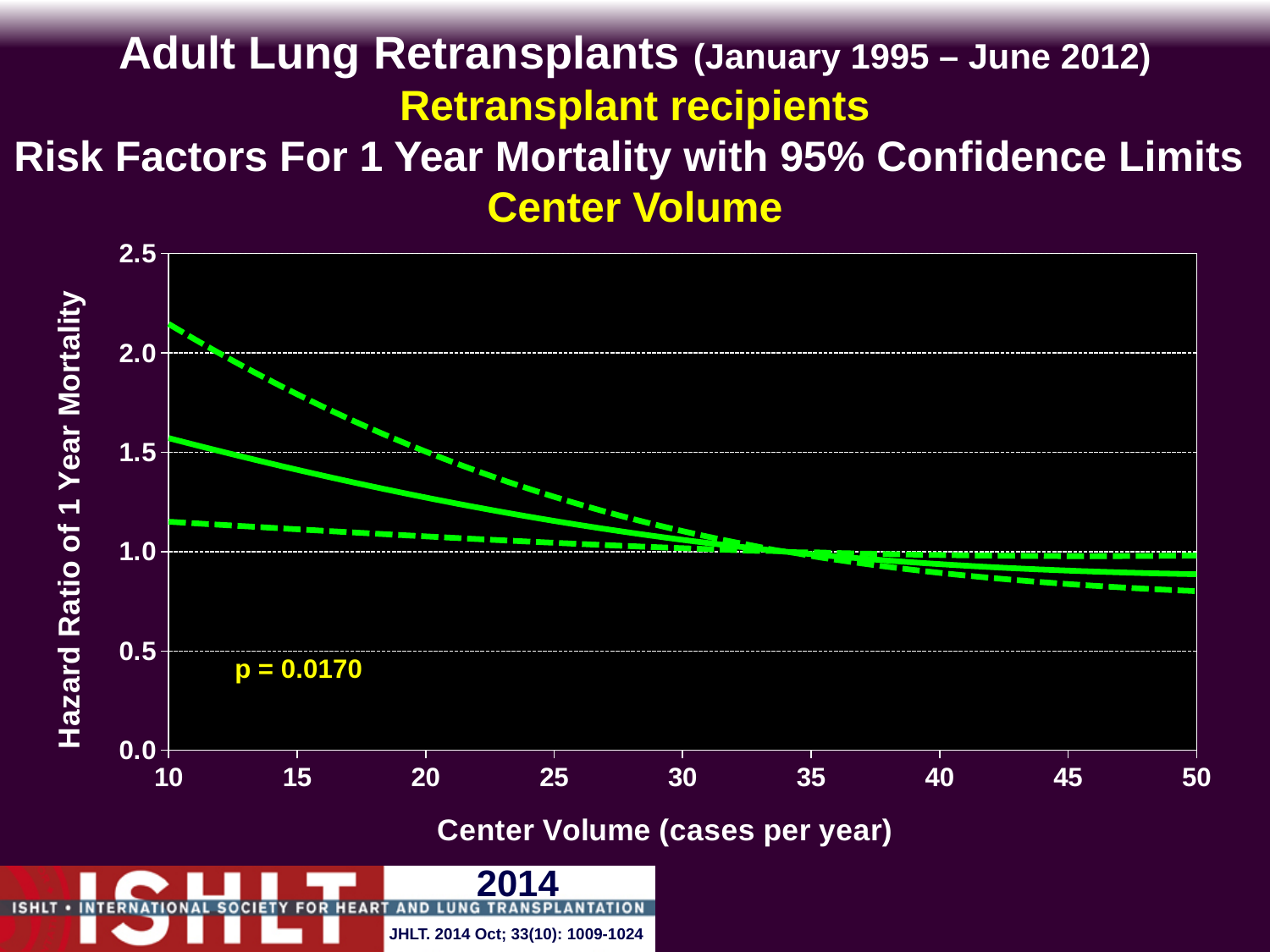
Is the lower 95% confidence limit (lower dashed line) at a center volume of 50 cases per year greater or less than 1.0? less Is the lower 95% confidence limit (lower dashed line) at a center volume of 10 cases per year greater or less than 1.0? greater What kind of chart is shown on the slide? line chart Is the hazard ratio (solid line) at a center volume of 10 cases per year greater or less than 1.0? greater How many tick marks are labeled on the x axis? 9 Does the hazard ratio of 1 year mortality rise or fall as center volume increases from 10 to 50 cases per year? fall What p-value is printed on the chart? p = 0.0170 What is the label of the x axis? Center Volume (cases per year) How many lines are plotted on the chart? 3